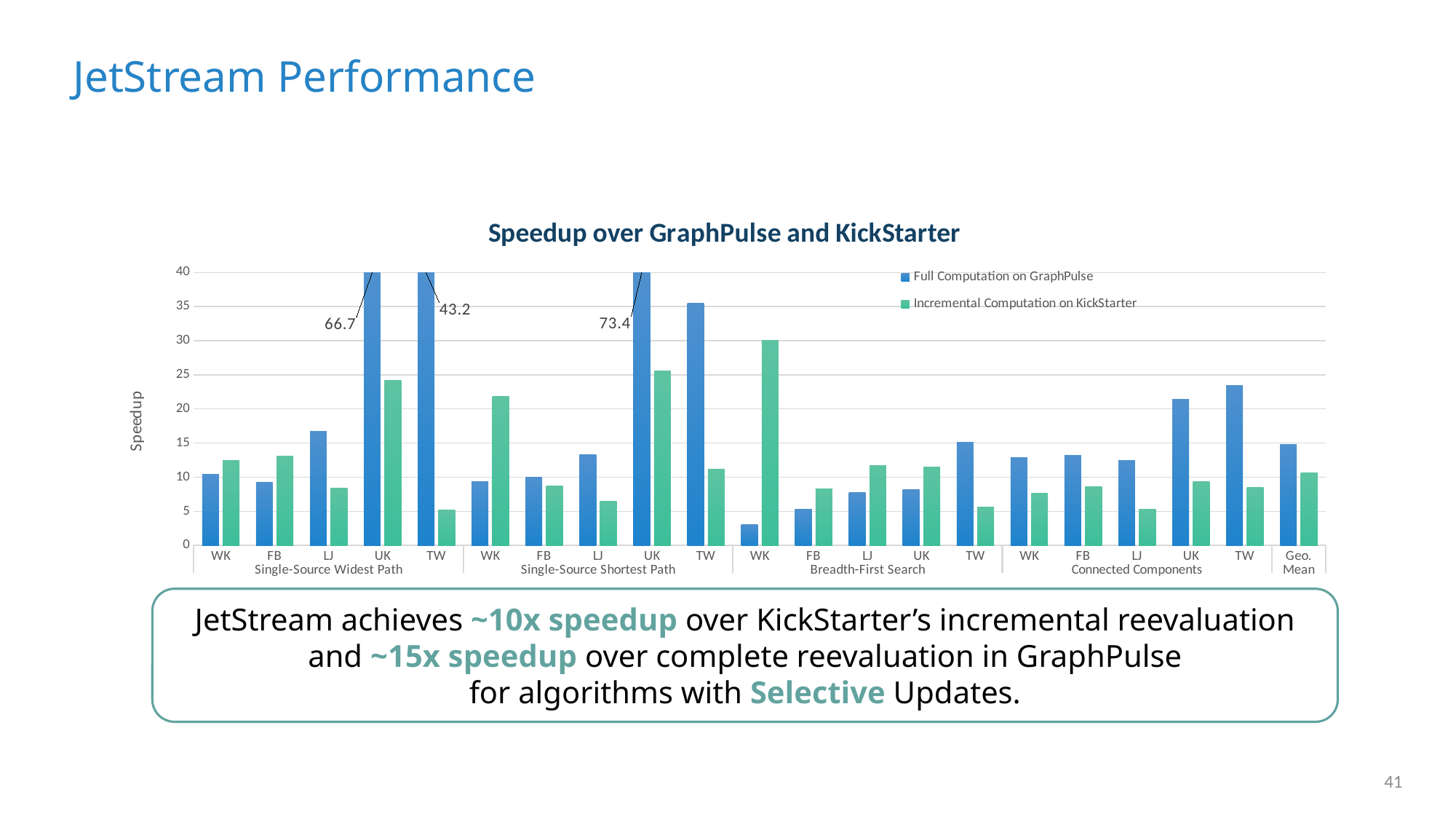
What is the title of the chart? Speedup over GraphPulse and KickStarter Is the Incremental Computation on KickStarter speedup for WK under Breadth-First Search greater or less than 25? greater How many series does the chart's legend list? 2 What type of chart is shown on the slide? bar chart Is the Incremental Computation on KickStarter speedup for Geo. Mean greater or less than 15? less What is the Full Computation on GraphPulse speedup for UK under Single-Source Widest Path? 66.7 Which bar has the highest speedup in the whole chart? Full Computation on GraphPulse for UK under Single-Source Shortest Path For Geo. Mean, which series has the larger speedup: Full Computation on GraphPulse or Incremental Computation on KickStarter? Full Computation on GraphPulse What is the label of the y axis? Speedup What is the difference between the Full Computation on GraphPulse speedups for UK under Single-Source Shortest Path and UK under Single-Source Widest Path? 6.7 What is the Full Computation on GraphPulse speedup for TW under Single-Source Widest Path? 43.2 What is the Full Computation on GraphPulse speedup for UK under Single-Source Shortest Path? 73.4